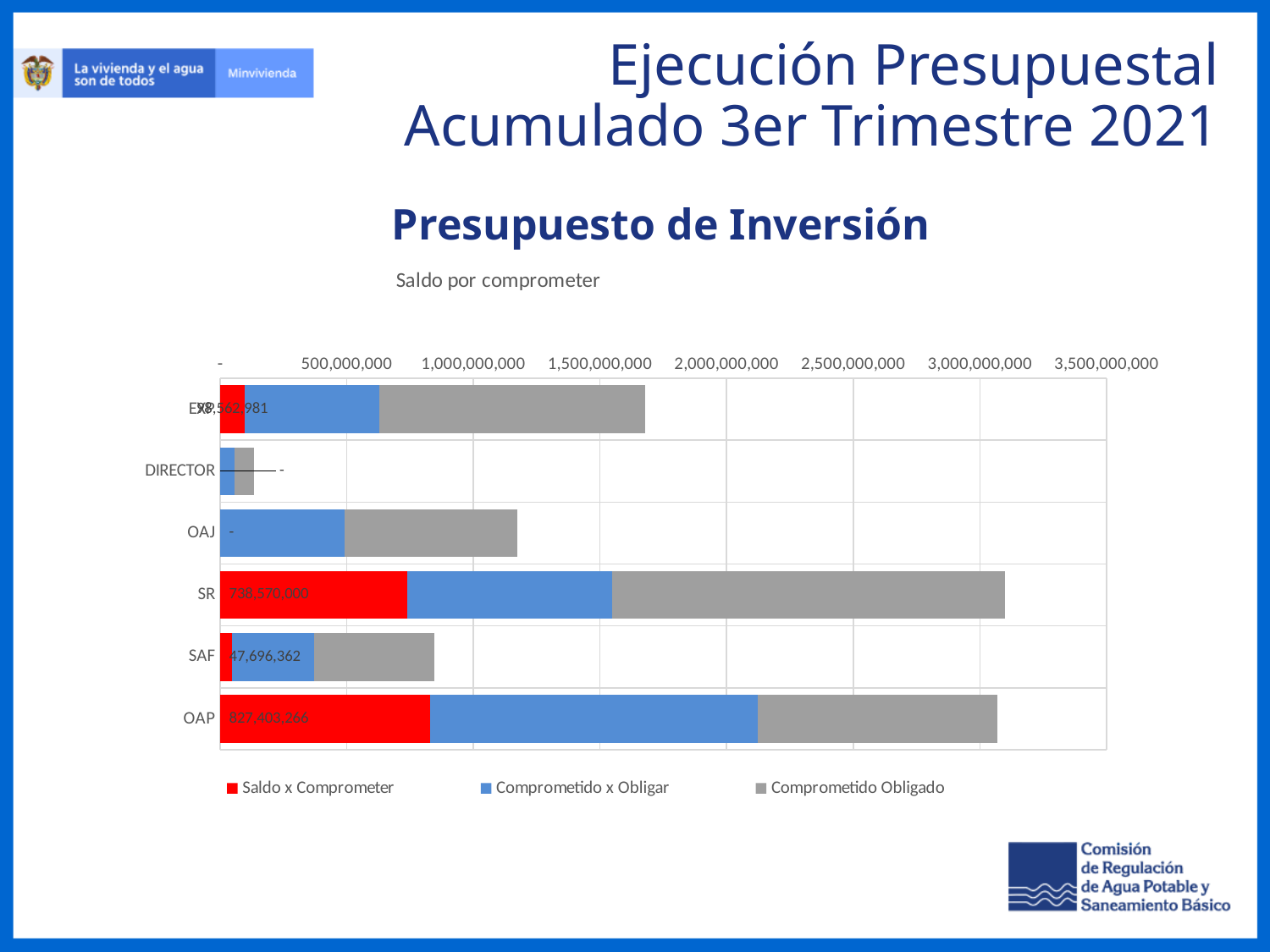
What kind of chart is shown on the slide? bar chart What colour represents the Saldo x Comprometer series in the chart? red Which has the larger Saldo x Comprometer value, SR or SAF? SR What is the difference between the Saldo x Comprometer values for OAP and SR? 88,833,266 How many series does the legend of the chart list? 3 Is the total length of the OAJ bar greater or less than 1,500,000,000? less How many categories are shown on the vertical axis of the chart? 6 What is the Saldo x Comprometer value for SAF? 47,696,362 What is the Saldo x Comprometer value for OAP? 827,403,266 Is the total length of the DIRECTOR bar greater or less than 500,000,000? less Which category has the highest Saldo x Comprometer value? OAP What is the Saldo x Comprometer value for SR? 738,570,000